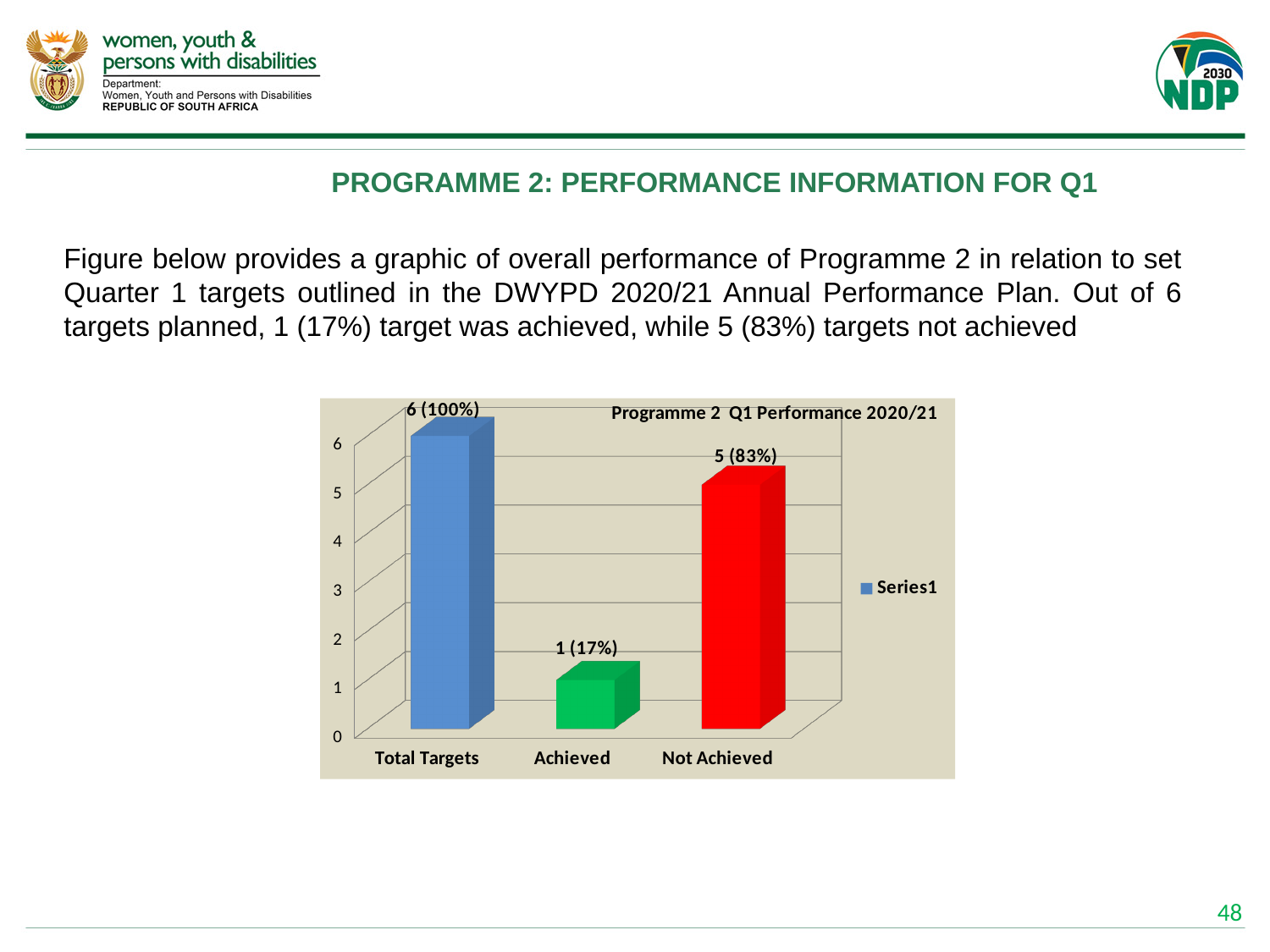
What kind of chart is shown? bar chart Which category has the highest value? Total Targets Which category has the lowest value? Achieved What is the title of the chart? Programme 2 Q1 Performance 2020/21 What is the value shown for Achieved? 1 (17%) How many categories are shown on the x axis? 3 What is the difference between the number of targets Not Achieved and the number Achieved? 4 What is the value shown for Total Targets? 6 (100%) What is the value shown for Not Achieved? 5 (83%) How many series does the legend list? 1 Which is larger, the value for Achieved or the value for Not Achieved? Not Achieved Is the value for Not Achieved greater or less than 3? greater